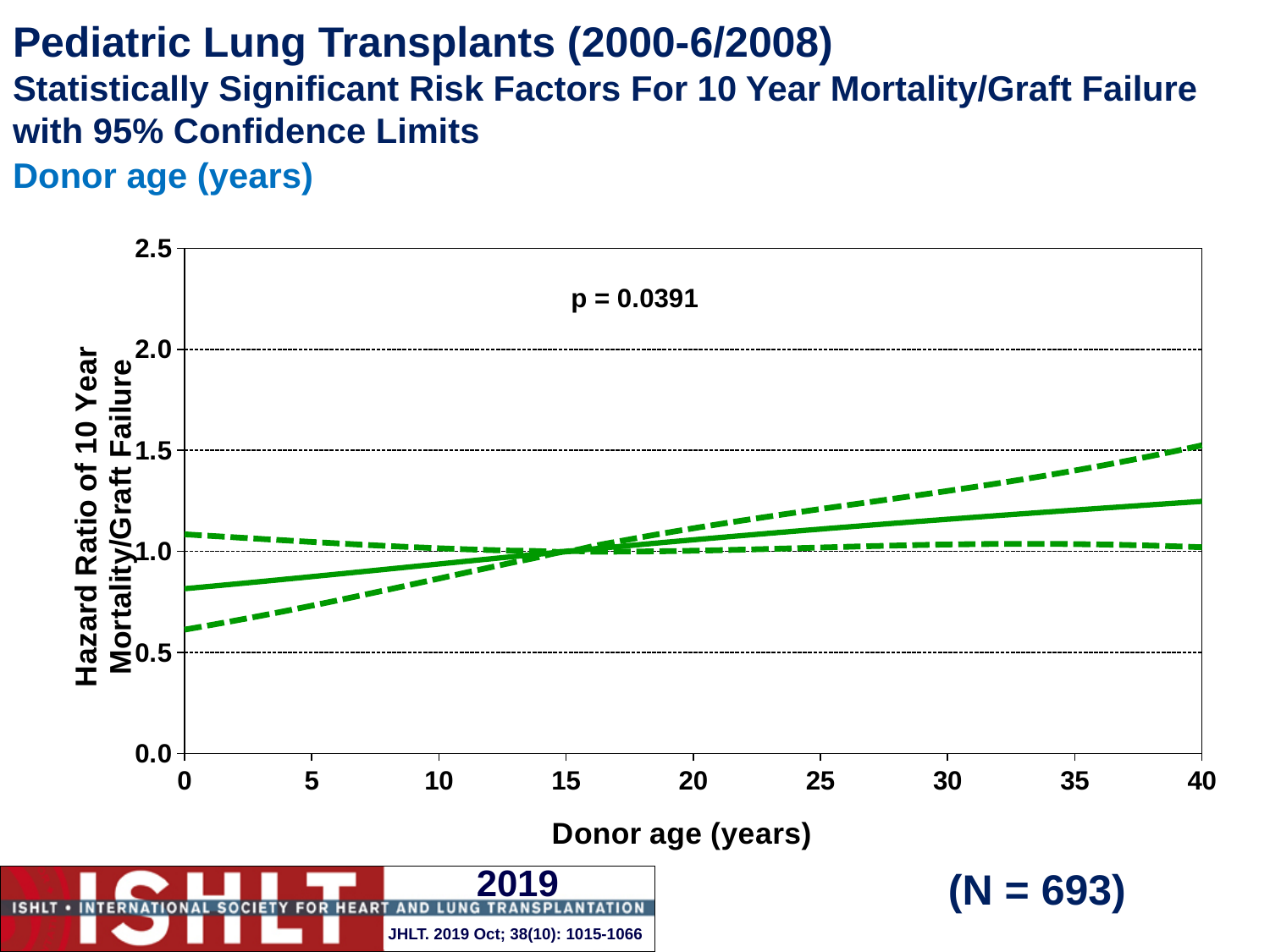
Is the hazard ratio (solid line) at donor age 0 greater or less than 1.0? less What kind of chart is shown on the slide? Line chart Does the solid hazard ratio line rise or fall as donor age increases from 0 to 40 years? Rises What is the sample size (N) shown on the slide? N = 693 Is the upper 95% confidence limit (upper dashed line) at donor age 40 greater or less than 1.0? greater Is the lower 95% confidence limit (lower dashed line) at donor age 0 greater or less than 0.5? greater Is the hazard ratio (solid line) higher at donor age 40 or at donor age 0? Donor age 40 What p-value is shown on the chart? p = 0.0391 How many lines are plotted on the chart? 3